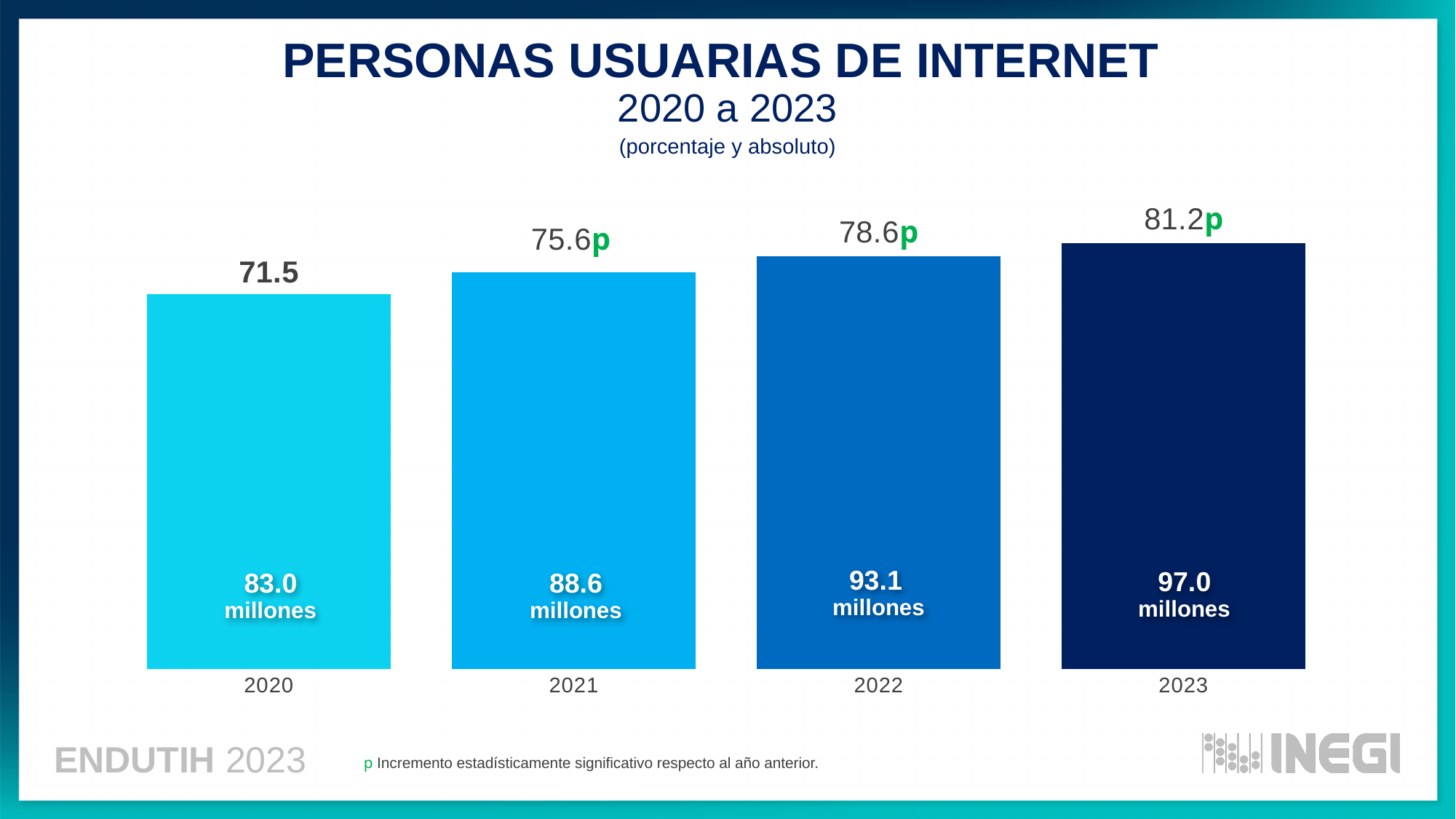
What percentage of internet users is shown for 2020? 71.5 Which year has the highest percentage of internet users? 2023 Do the percentages rise or fall from 2020 to 2023? Rise Which year has the lowest number of internet users in millions? 2020 Which year has a higher percentage of internet users, 2021 or 2022? 2022 How many millions of internet users are shown for 2021? 88.6 millones How many years are shown in the chart? 4 What percentage of internet users is shown for 2023? 81.2 What kind of chart is shown on the slide? Bar chart How many millions of internet users are shown for 2022? 93.1 millones What is the difference in percentage points between 2023 and 2020? 9.7 What is the difference in millions of internet users between 2022 and 2021? 4.5